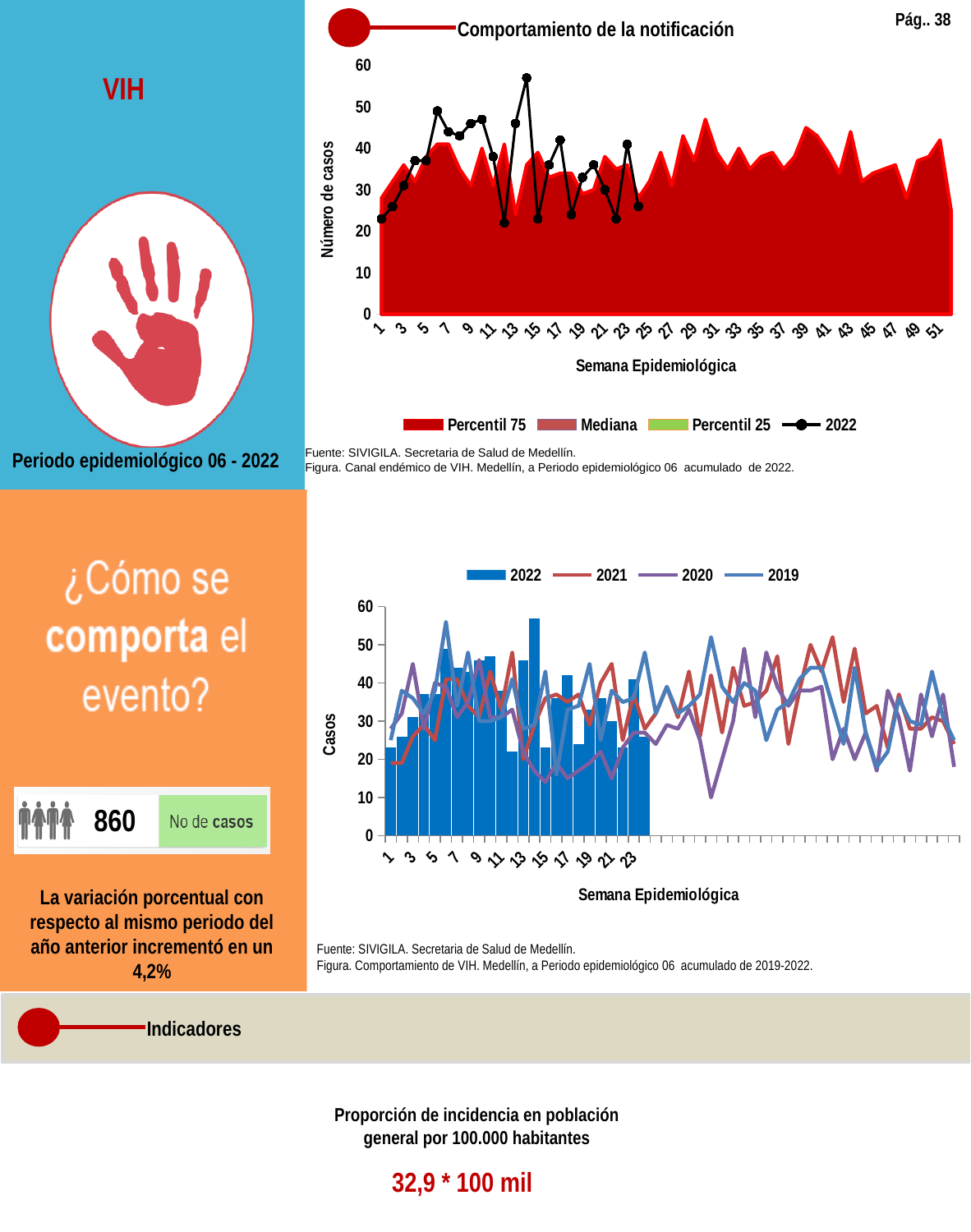
In the top chart 'Comportamiento de la notificación', is the 2022 value at week 1 greater or less than 30? less In the bottom chart 'Comportamiento de VIH', is the 2022 bar at week 14 greater or less than 50? greater In the top chart 'Comportamiento de la notificación', is the 2022 value at week 14 greater or less than 50? greater In the bottom chart 'Comportamiento de VIH', which year is shown as bars rather than a line? 2022 In the top chart 'Comportamiento de la notificación', at which epidemiological week does the 2022 line reach its highest value? 14 In the bottom chart 'Comportamiento de VIH', how many series does the legend list? 4 In the bottom chart 'Comportamiento de VIH', at which epidemiological week is the 2022 bar the tallest? 14 In the top chart 'Comportamiento de la notificación', what is the label of the y axis? Número de casos In the top chart 'Comportamiento de la notificación', what kind of chart is used for the 2022 series? line chart In the top chart 'Comportamiento de la notificación', which is larger for the 2022 series: the value at week 14 or the value at week 1? week 14 In the top chart 'Comportamiento de la notificación', how many series does the legend list? 4